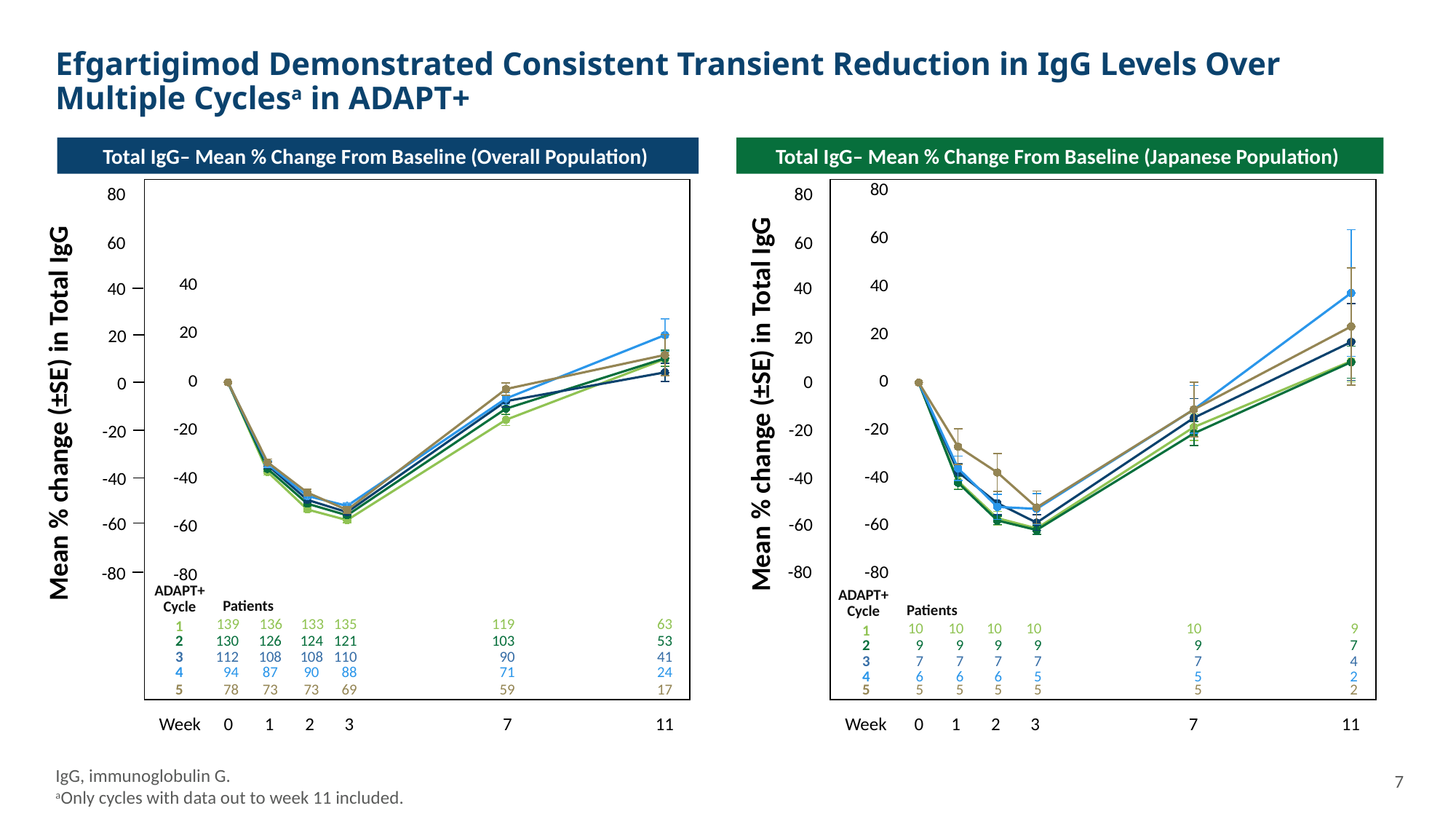
How many ADAPT+ cycles (series) are plotted in the Overall Population chart? 5 In the Overall Population chart, do the mean % change values rise or fall from week 3 to week 11? rise In the Overall Population chart, which cycle had more patients at week 7, Cycle 1 or Cycle 2? Cycle 1 In the Japanese Population chart, how many patients were in ADAPT+ Cycle 5 at week 11? 2 In the Overall Population chart, how many more patients were in Cycle 1 at week 0 than at week 11? 76 In the Overall Population chart, is the mean % change for Cycle 1 at week 3 greater or less than -40? less In the Overall Population chart, at which week do the lines reach their lowest mean % change? Week 3 What kind of chart is the Total IgG Overall Population chart? line chart In the Japanese Population chart, is the mean % change for Cycle 4 at week 11 greater or less than 20? greater What is the title of the chart on the right of the slide? Total IgG– Mean % Change From Baseline (Japanese Population) In the Overall Population chart, how many patients were in ADAPT+ Cycle 1 at week 0? 139 How many weeks are marked on the x axis of the Japanese Population chart? 6